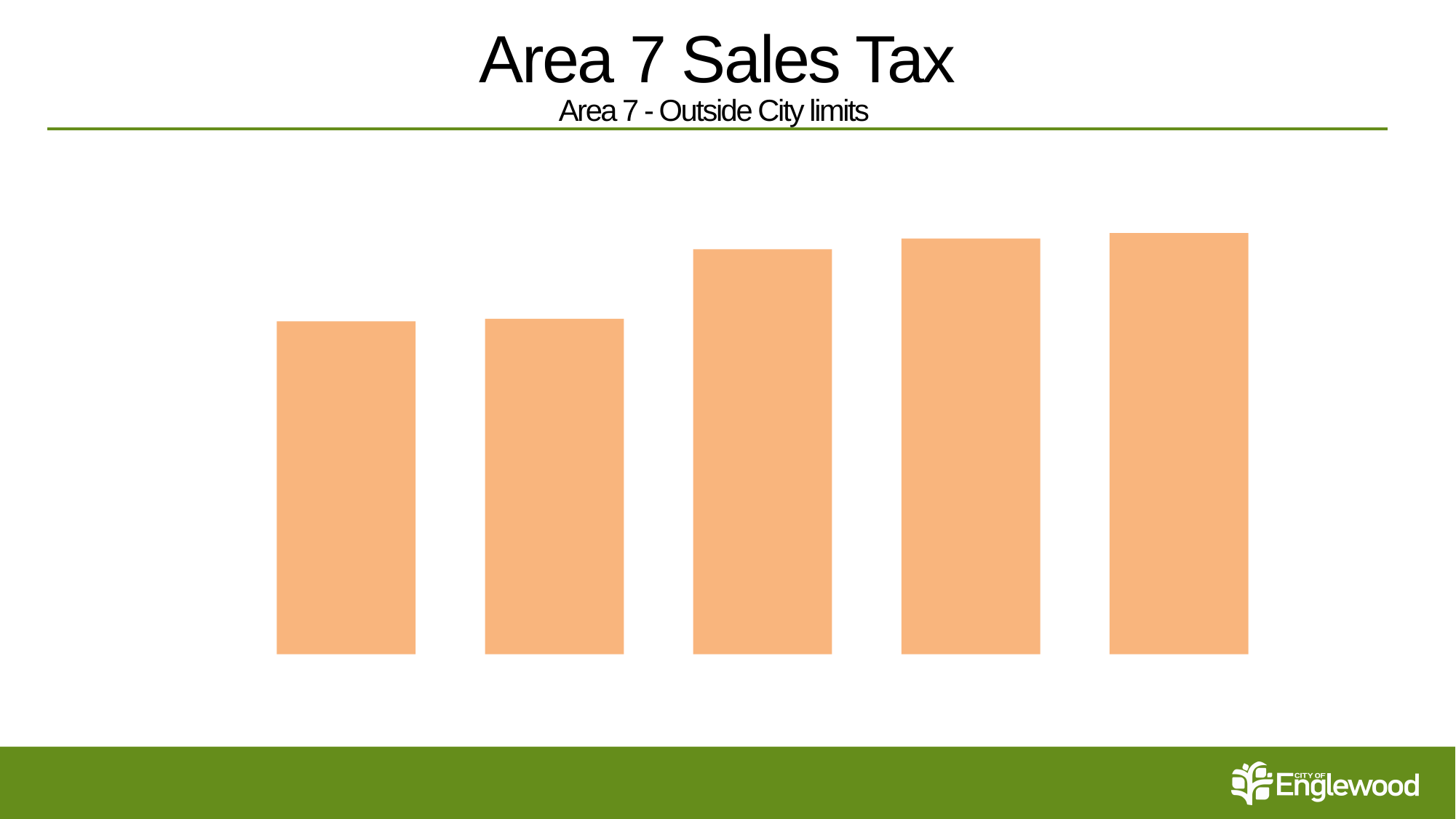
Which is taller, the second bar or the fifth bar? the fifth bar Which is taller, the second bar or the fourth bar? the fourth bar What kind of chart is shown on the slide? bar chart Which is taller, the first bar or the third bar? the third bar What is the title of the slide containing the chart? Area 7 Sales Tax Which bar is the tallest in the chart? the rightmost (fifth) bar How many bars does the chart show? 5 Which bar is the shortest in the chart? the leftmost (first) bar Do the bar values rise or fall from left to right across the chart? rise What colour are the bars in the chart? orange